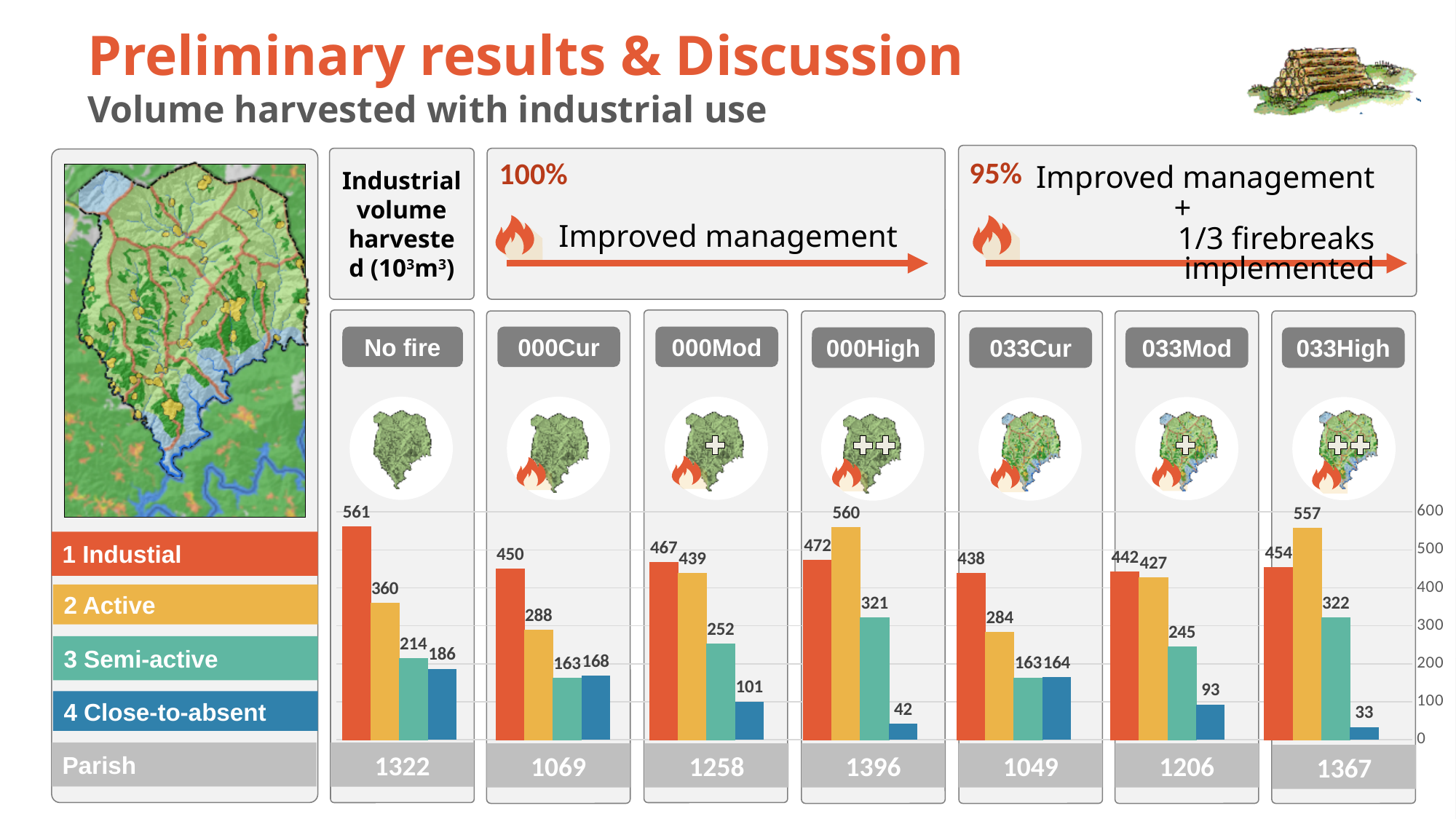
In the 000High chart, what is the value for Active? 560 What is the Parish total shown below the 000High chart? 1396 In the 033Cur chart, is the value for Industrial greater or less than 400? greater In the 033High chart, what is the value for Close-to-absent? 33 How many bars are shown in the 000High chart? 4 In the 000Cur chart, what is the difference between the Industrial value and the Active value? 162 What colour represents the Active category in the charts? Yellow/orange In the 033Mod chart, which is larger, the Semi-active value or the Close-to-absent value? Semi-active In the 000Mod chart, which category has the lowest value? Close-to-absent In the 033High chart, which category has the highest value? Active What kind of chart is used for the No fire scenario? bar chart In the No fire chart, what is the value for Industrial? 561